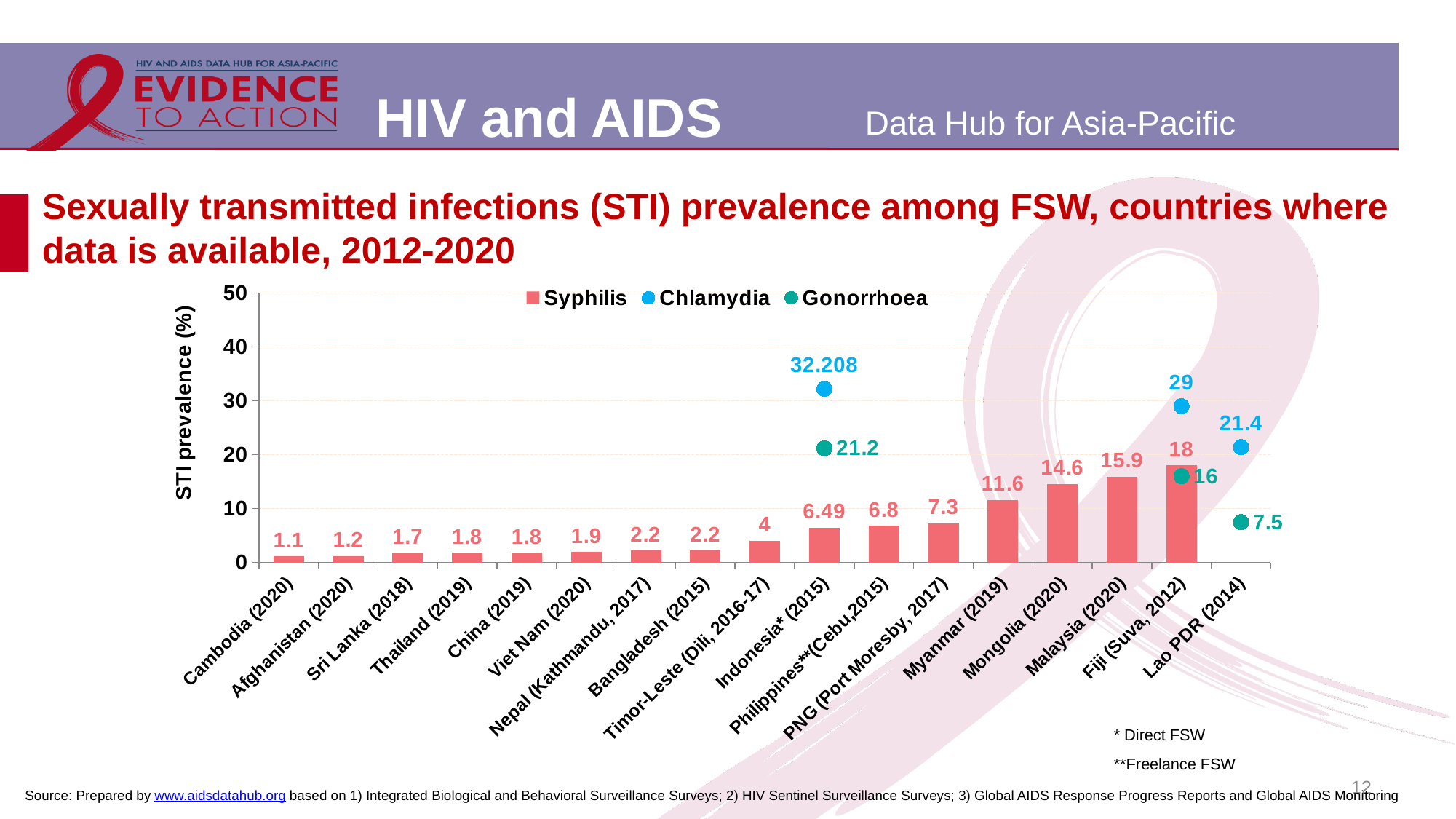
Is the chlamydia prevalence for Indonesia* (2015) greater or less than 30? greater What is the difference between the chlamydia and gonorrhoea prevalence for Fiji (Suva, 2012)? 13 What is the gonorrhoea prevalence for Lao PDR (2014)? 7.5 Do the syphilis prevalence values rise or fall from left to right along the x axis? rise Which country has the highest syphilis prevalence? Fiji (Suva, 2012) How many countries are shown on the x axis? 17 What is the chlamydia prevalence for Indonesia* (2015)? 32.208 Which has the higher syphilis prevalence, Mongolia (2020) or Malaysia (2020)? Malaysia (2020) What kind of chart is used to show syphilis prevalence? bar chart Which country has the lowest syphilis prevalence? Cambodia (2020) How many series does the legend list? 3 What is the syphilis prevalence for Myanmar (2019)? 11.6